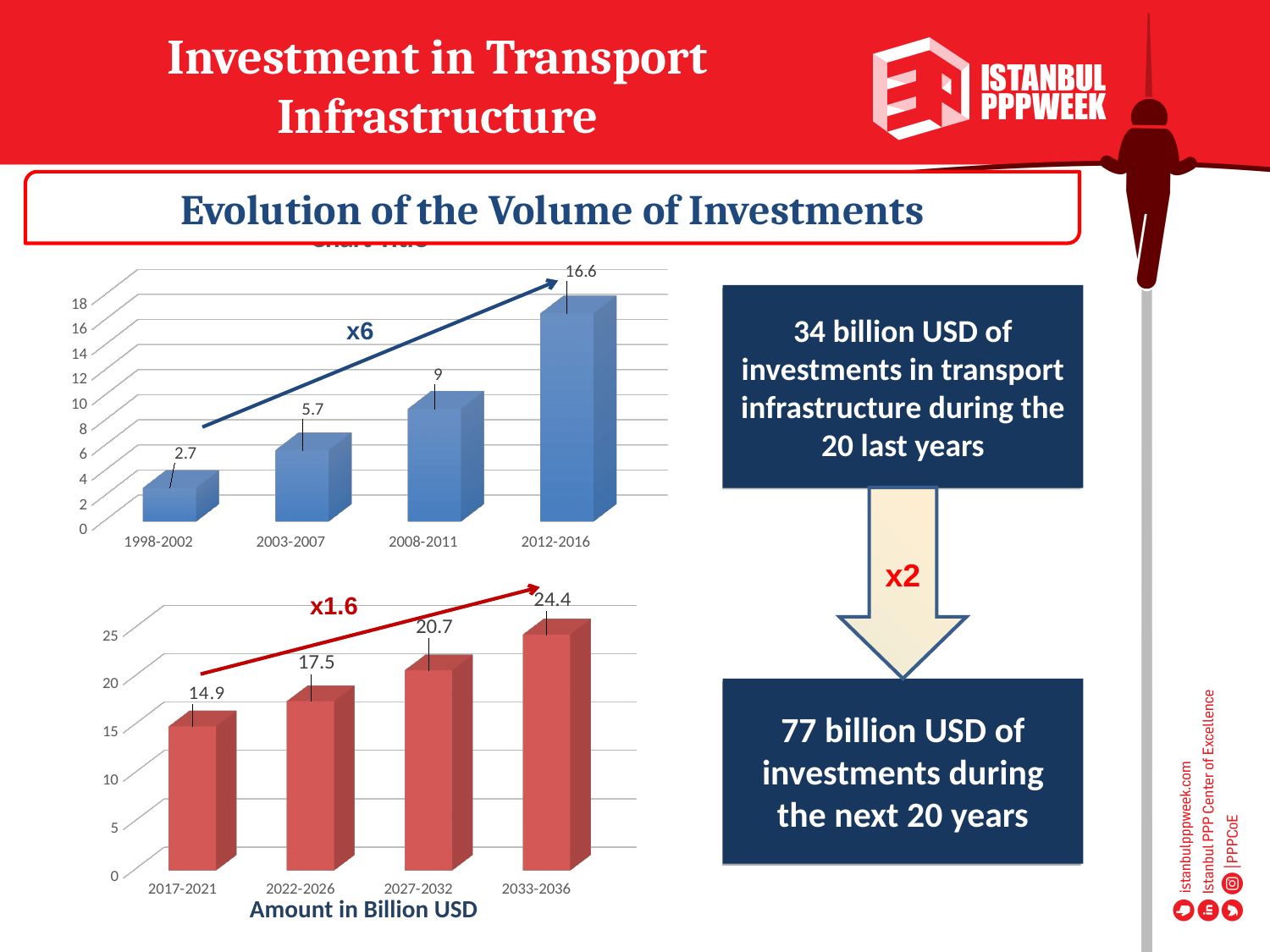
In the bottom chart, what is the value for 2027-2032? 20.7 In the bottom chart, what is the value for 2017-2021? 14.9 In the bottom chart, what is the difference between the values for 2033-2036 and 2017-2021? 9.5 In the top chart, what is the value for 2003-2007? 5.7 In the top chart, do the values rise or fall from 1998-2002 to 2012-2016? rise How many periods are shown on the x axis of the bottom chart? 4 In the top chart, which period has the lowest value? 1998-2002 In the bottom chart, which period has the highest value? 2033-2036 In the bottom chart, which is larger, the value for 2022-2026 or the value for 2027-2032? 2027-2032 In the top chart, what is the difference between the values for 2012-2016 and 2008-2011? 7.6 In the top chart, what is the value for 2012-2016? 16.6 What kind of chart is the top chart? bar chart